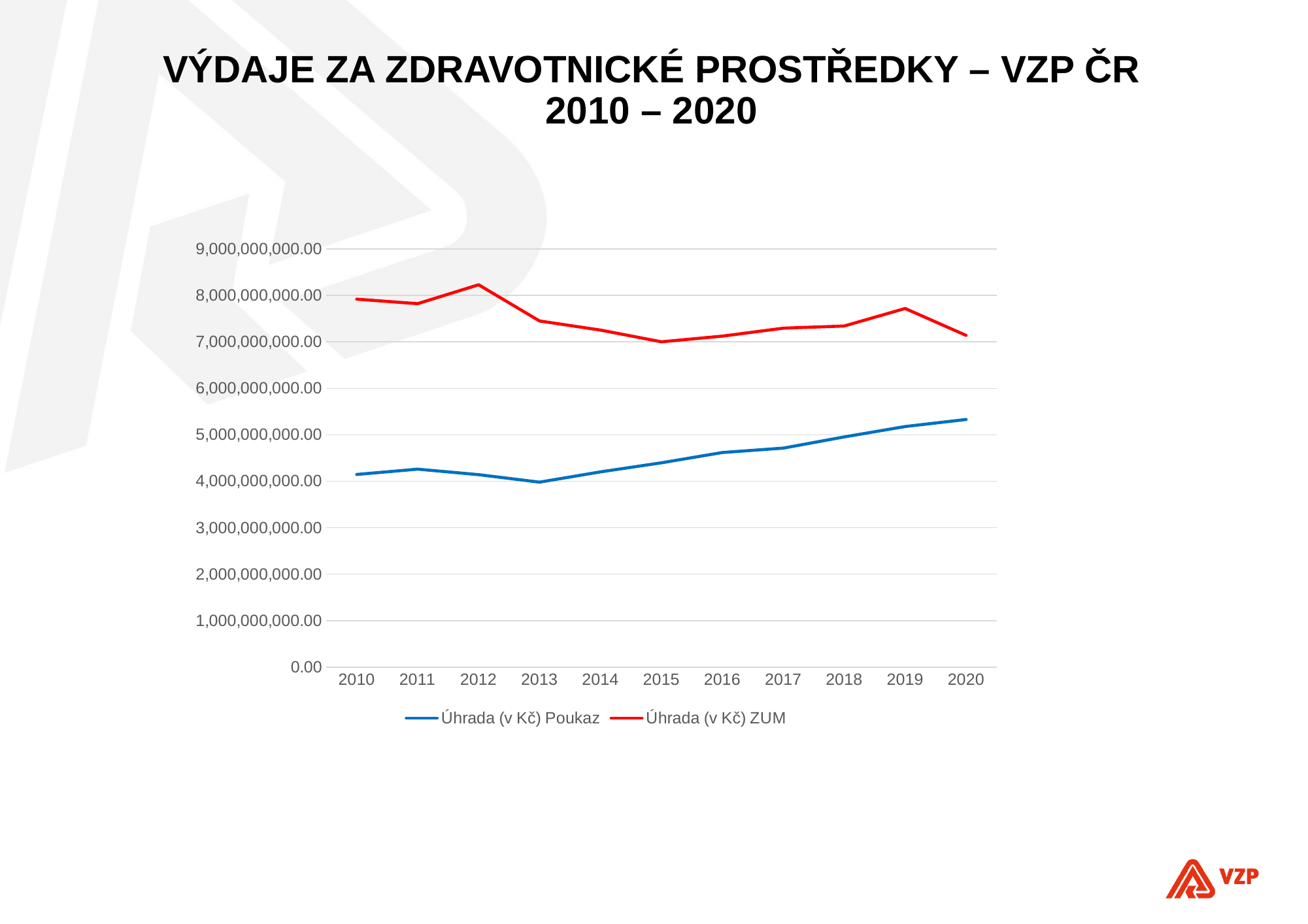
How many years are plotted along the x axis? 11 Does the value for Úhrada (v Kč) Poukaz rise or fall from 2013 to 2020? rise What kind of chart is shown on the slide? line chart Is the value for Úhrada (v Kč) ZUM in 2012 greater or less than 8,000,000,000.00? greater In which year is the value for Úhrada (v Kč) Poukaz highest? 2020 Which colour is used for the Úhrada (v Kč) ZUM line? red Is the value for Úhrada (v Kč) ZUM in 2013 greater or less than 8,000,000,000.00? less In which year is the value for Úhrada (v Kč) ZUM highest? 2012 Which series has the larger value in 2020, Úhrada (v Kč) Poukaz or Úhrada (v Kč) ZUM? Úhrada (v Kč) ZUM In which year is the value for Úhrada (v Kč) Poukaz lowest? 2013 Is the value for Úhrada (v Kč) Poukaz in 2020 greater or less than 5,000,000,000.00? greater How many series does the legend list? 2